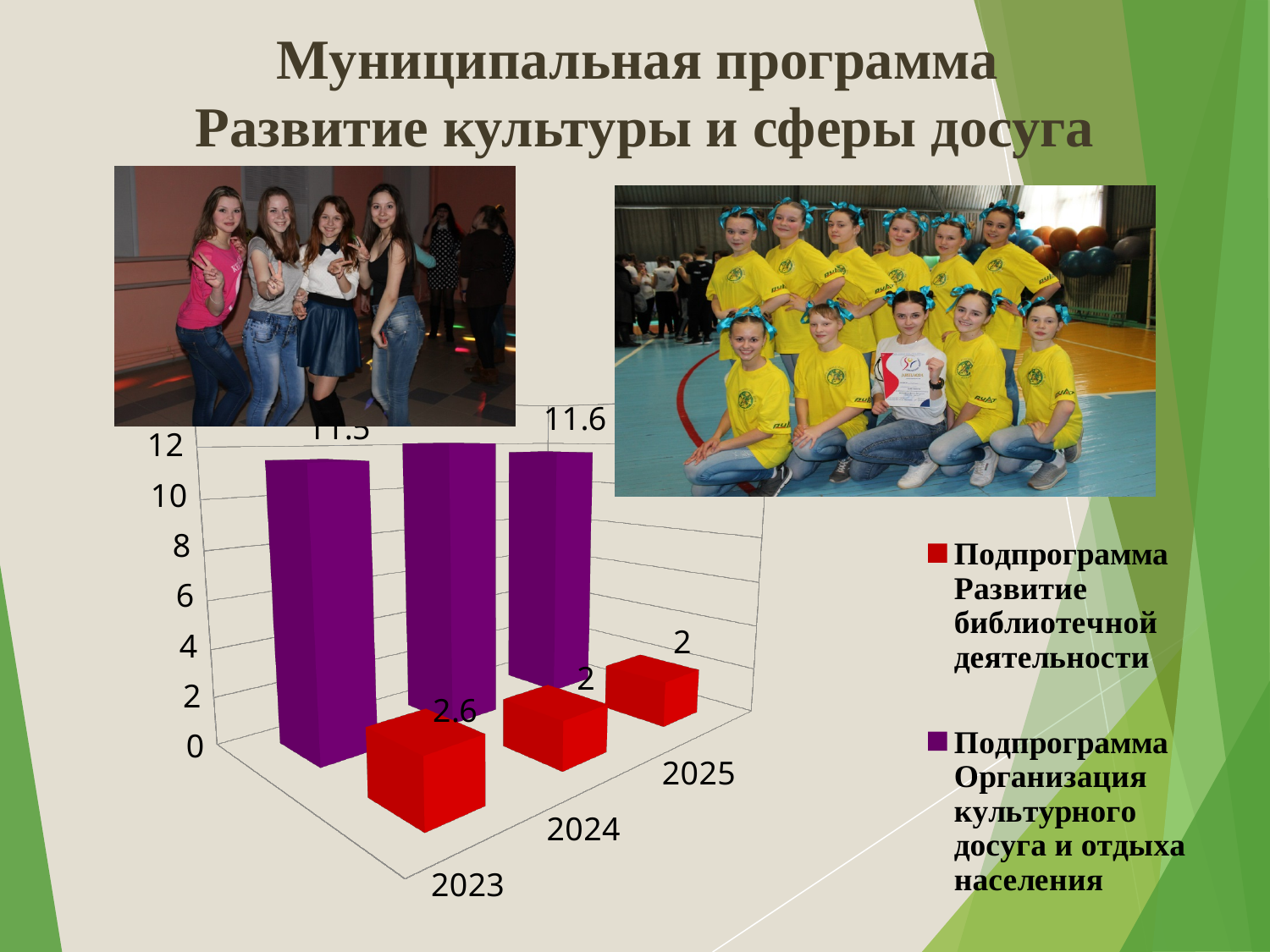
How many series does the legend list? 2 How many years are shown on the x axis of the chart? 3 What kind of chart is shown on the slide? Bar chart In which year is the value for Подпрограмма Развитие библиотечной деятельности highest? 2023 In 2025, which subprogramme has the larger value? Подпрограмма Организация культурного досуга и отдыха населения What is the value for Подпрограмма Развитие библиотечной деятельности in 2023? 2.6 What is the value for Подпрограмма Организация культурного досуга и отдыха населения in 2025? 11.6 Is the 2024 value for Подпрограмма Развитие библиотечной деятельности greater or less than 4? less Is the 2023 value for Подпрограмма Организация культурного досуга и отдыха населения greater or less than 10? greater What is the difference between the 2023 and 2025 values for Подпрограмма Развитие библиотечной деятельности? 0.6 Which colour represents Подпрограмма Развитие библиотечной деятельности in the chart? Red What is the value for Подпрограмма Развитие библиотечной деятельности in 2024? 2